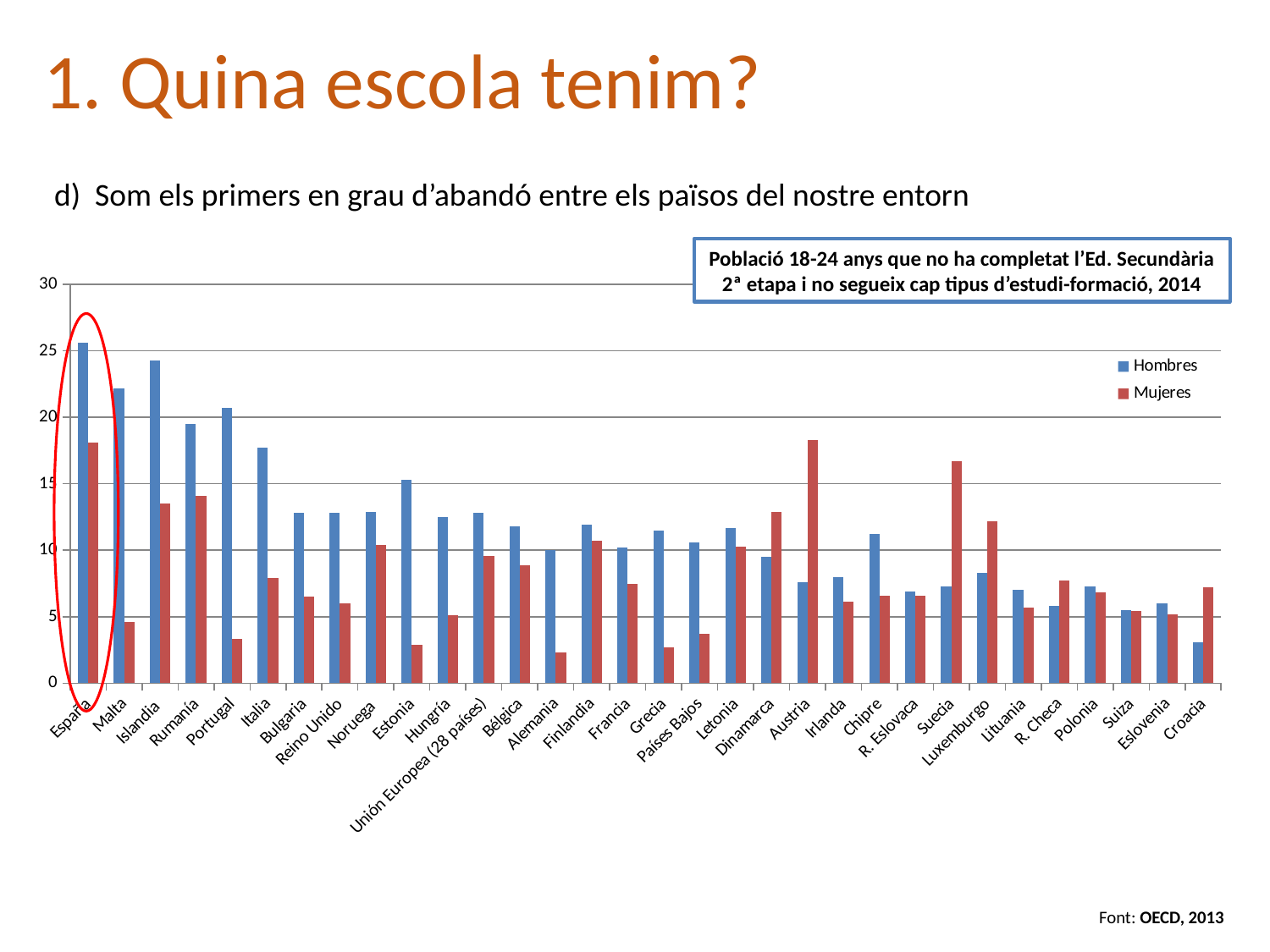
What kind of chart is shown on the slide? bar chart How many series does the chart legend list? 2 For Portugal, which series has the larger value, Hombres or Mujeres? Hombres Is the Hombres value for Croacia greater or less than 5? less Which category has the lowest value for the Hombres series? Croacia Is the Mujeres value for Austria greater or less than 15? greater Is the Mujeres value for Portugal greater or less than 5? less Which category has the highest value for the Hombres series? España How many countries/categories are shown on the x axis of the chart? 32 For Austria, which series has the larger value, Hombres or Mujeres? Mujeres Which colour represents the Mujeres series in the chart? red